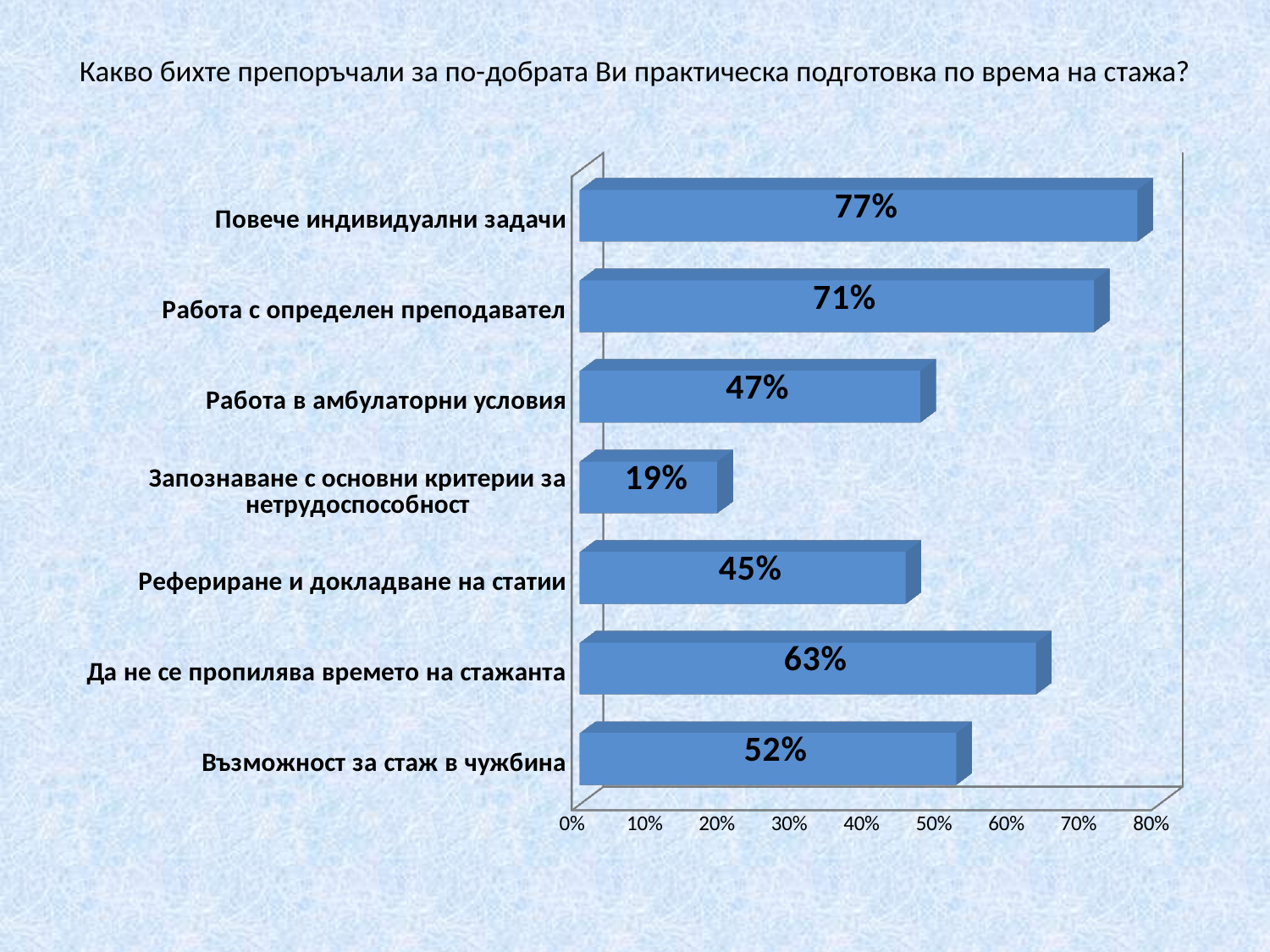
What is the value for "Възможност за стаж в чужбина"? 52% What is the value for "Работа в амбулаторни условия"? 47% Which is larger: the value for "Рефериране и докладване на статии" or the value for "Работа в амбулаторни условия"? Работа в амбулаторни условия Is the value for "Да не се пропилява времето на стажанта" greater or less than 50%? greater Which category has the highest value? Повече индивидуални задачи What kind of chart is shown on the slide? bar chart What is the difference between the highest and lowest values in the chart? 58% What is the value for "Повече индивидуални задачи"? 77% What is the difference between the values for "Работа с определен преподавател" and "Да не се пропилява времето на стажанта"? 8% Which category has the lowest value? Запознаване с основни критерии за нетрудоспособност What is the title of the slide? Какво бихте препоръчали за по-добрата Ви практическа подготовка по време на стажа? How many categories are shown in the chart? 7